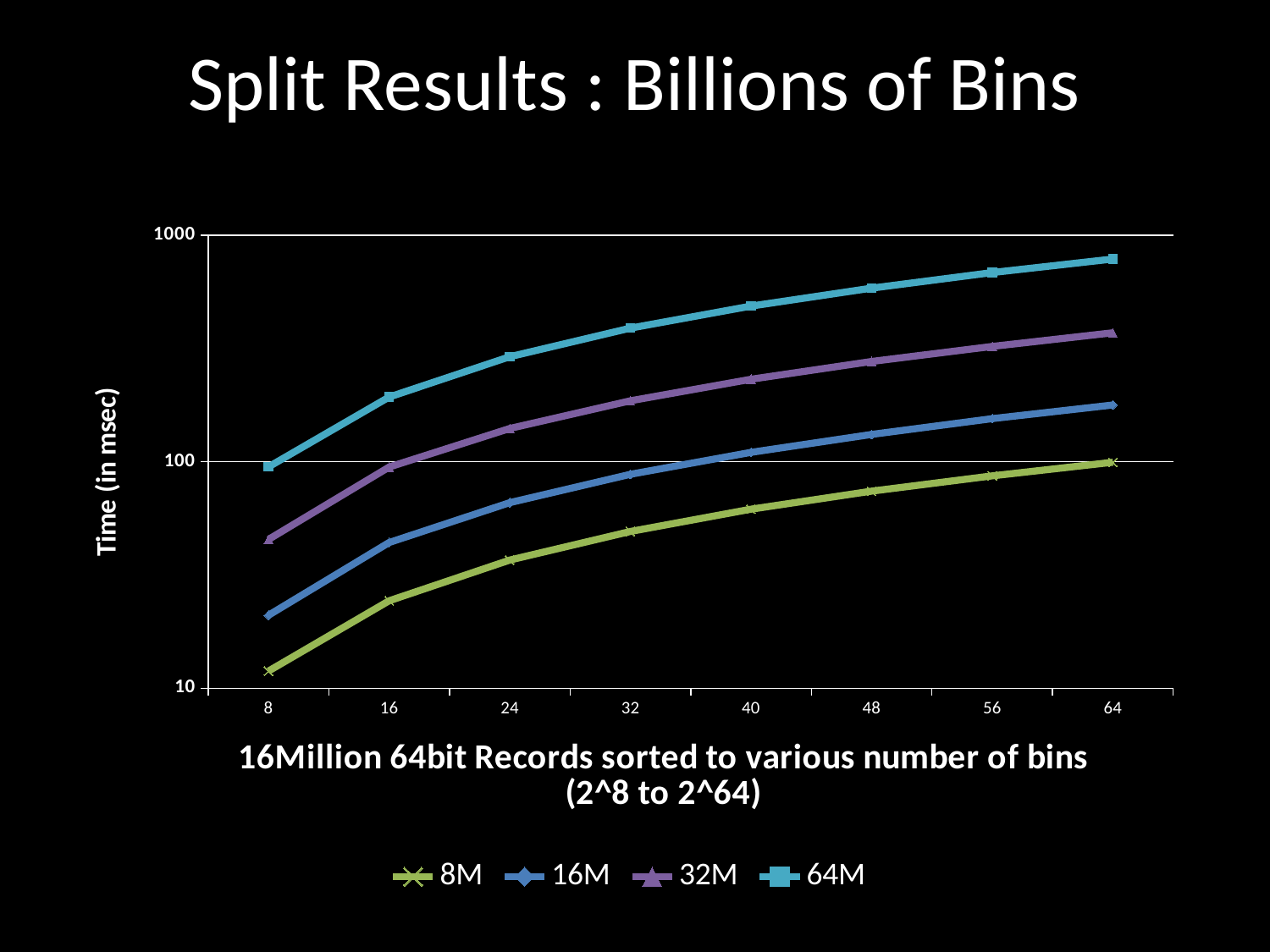
Is the value for the 32M series at x = 8 greater or less than 100? less What is the label on the y axis? Time (in msec) Is the value for the 8M series at x = 8 greater or less than 100? less Which series has the lowest time at x = 8? 8M Do the values for the 8M series rise or fall as the number of bins increases along the x axis? rise How many x-axis points are plotted for each series? 8 Is the value for the 64M series at x = 64 greater or less than 1000? less At x = 48, which series has the larger value, 16M or 32M? 32M How many series does the legend list? 4 What kind of chart is shown on the slide? line chart Which series has the highest time at x = 64? 64M